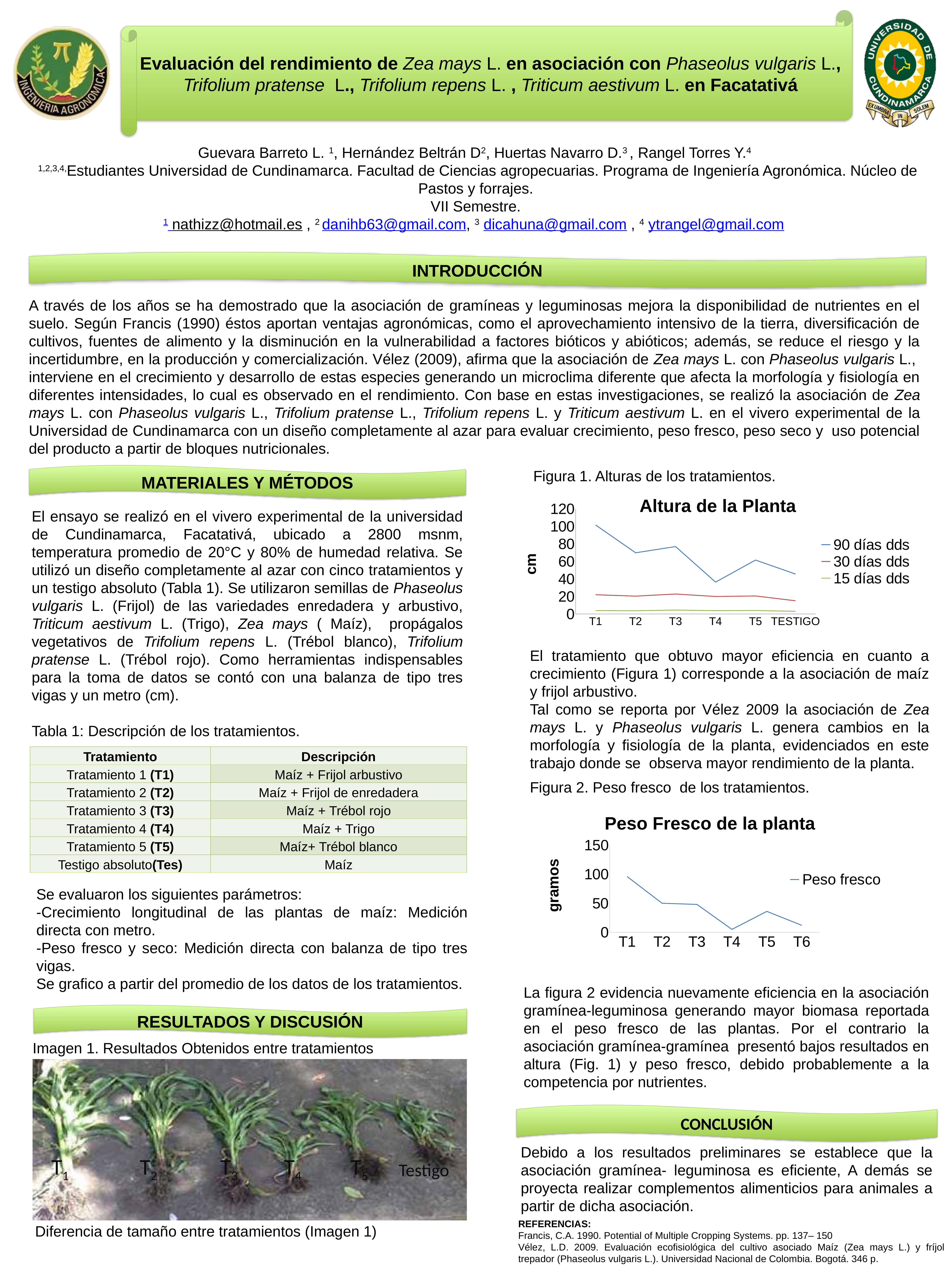
In the "Altura de la Planta" chart, is the 90 días dds value for T1 greater or less than 80? greater What kind of chart is the "Altura de la Planta" chart? line chart In the "Peso Fresco de la planta" chart, is the value for T1 greater or less than 50? greater In the "Altura de la Planta" chart, which category has the highest value for the 90 días dds series? T1 In the "Altura de la Planta" chart, which series has the lowest values across all treatments? 15 días dds In the "Peso Fresco de la planta" chart, which category has the highest value? T1 How many categories are shown on the x axis of the "Altura de la Planta" chart? 6 In the "Altura de la Planta" chart, which category has the lowest value for the 90 días dds series? T4 What is the y-axis label of the "Peso Fresco de la planta" chart? gramos How many series does the legend of the "Altura de la Planta" chart list? 3 In the "Altura de la Planta" chart, is the 90 días dds value for TESTIGO greater or less than 60? less In the "Peso Fresco de la planta" chart, which category has the lowest value? T4